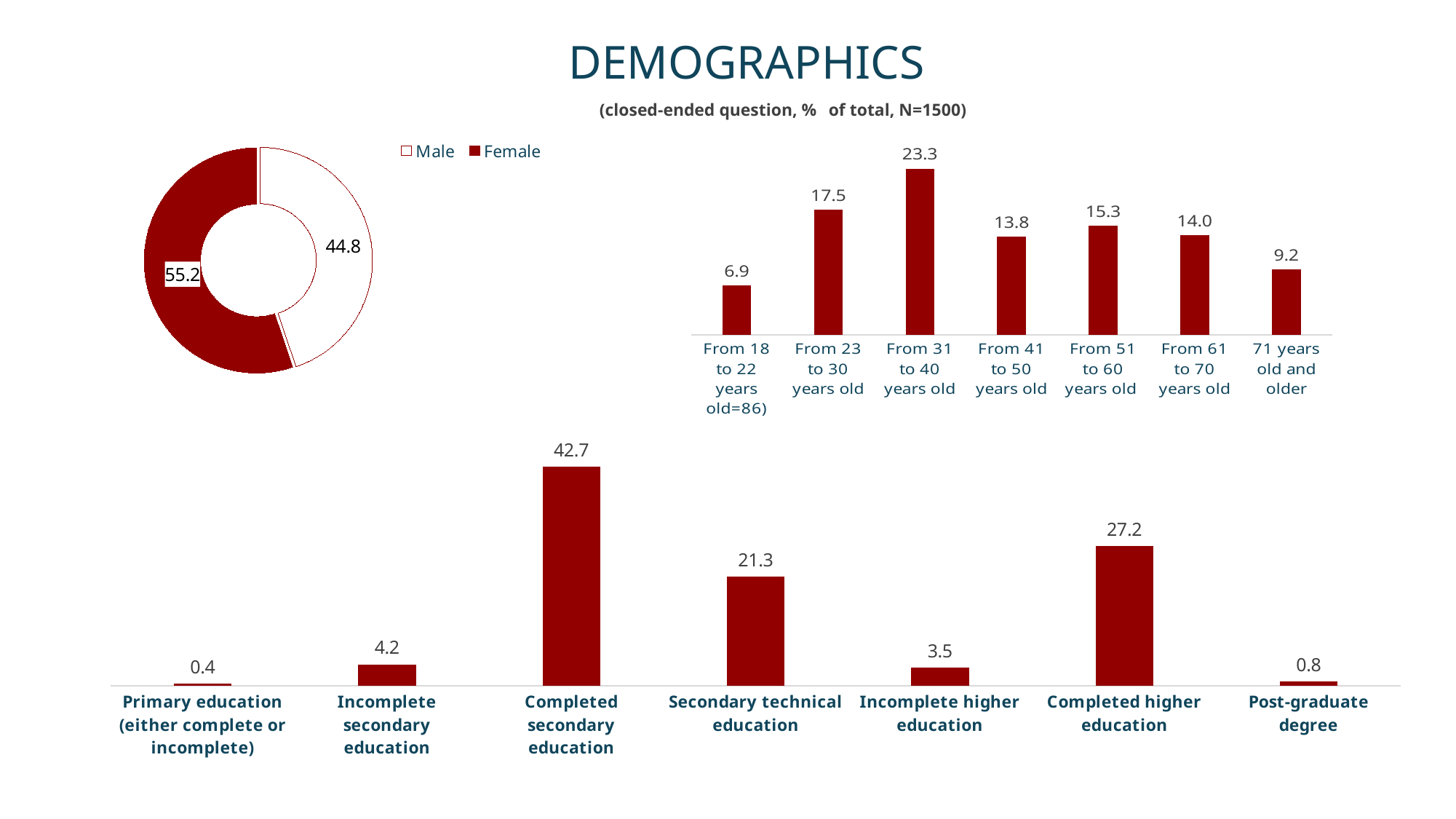
In the age bar chart at the top right, what is the difference between From 23 to 30 years old and From 51 to 60 years old? 2.2 In the education bar chart at the bottom, which category has the lowest value? Primary education (either complete or incomplete) What kind of chart is the bottom chart showing education levels? Bar chart In the education bar chart at the bottom, what is the value for Completed higher education? 27.2 In the age bar chart at the top right, how many age groups are shown? 7 In the doughnut chart at the top left, what is the value for Male? 44.8 In the education bar chart at the bottom, which category has the highest value? Completed secondary education In the doughnut chart at the top left, what is the value for Female? 55.2 In the education bar chart at the bottom, what is the difference between Completed secondary education and Secondary technical education? 21.4 In the age bar chart at the top right, which age group has the lowest value? From 18 to 22 years old=86 In the doughnut chart at the top left, which is larger, Male or Female? Female In the age bar chart at the top right, what is the value for From 31 to 40 years old? 23.3